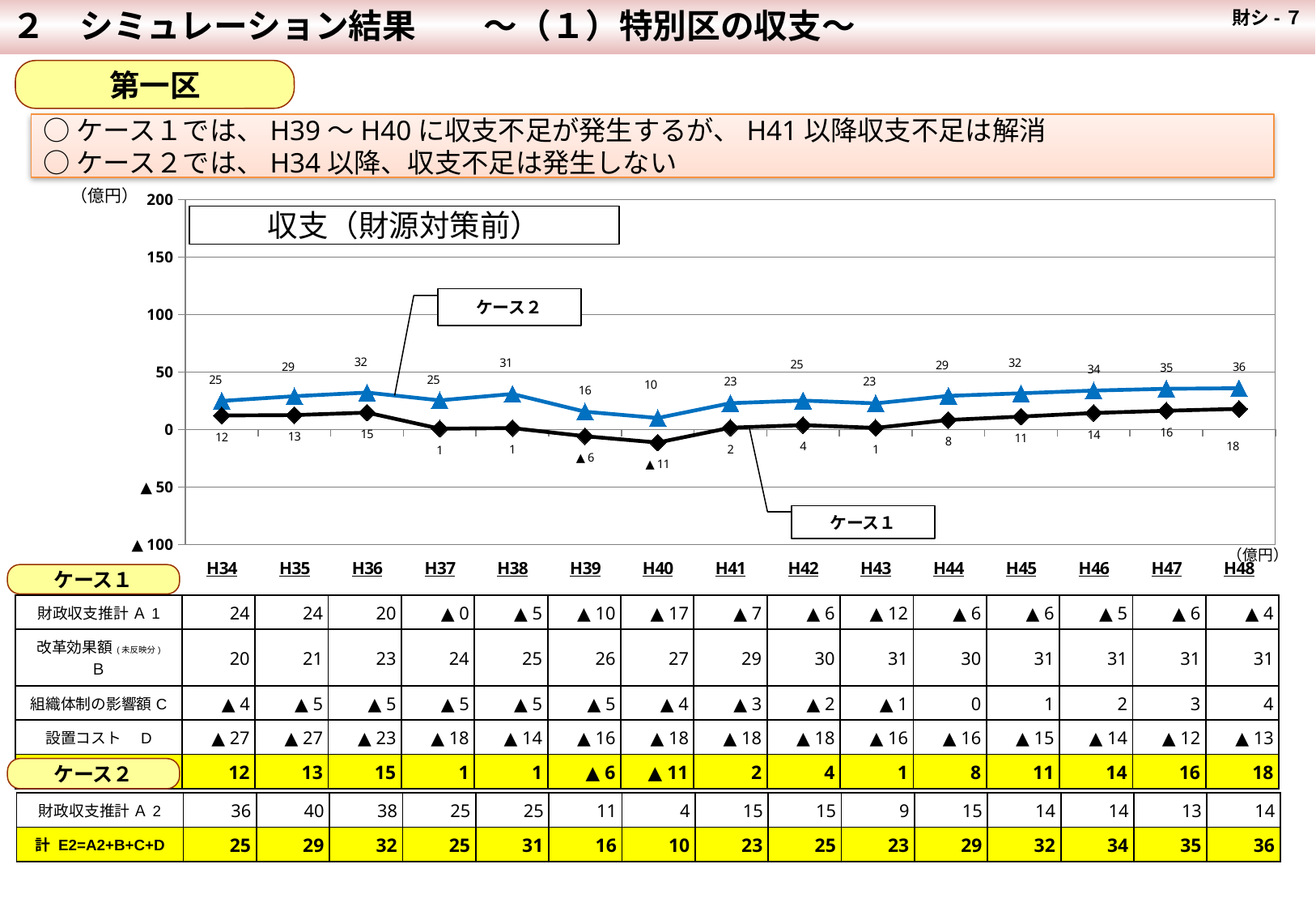
What is the value of ケース2 at H48? 36 What is the value of ケース2 at H40? 10 In which year does ケース2 reach its highest value? H48 Which series has the higher value at H38, ケース1 or ケース2? ケース2 What is the value of ケース1 at H39? ▲6 How many years (data points per series) are plotted along the x axis? 15 Do the values of ケース2 rise or fall from H41 to H48? rise How many series are plotted in the chart? 2 What type of chart is shown on the slide? line chart What is the difference between ケース2 and ケース1 at H36? 17 In which year does ケース1 reach its lowest value? H40 What is the title of the chart? 収支（財源対策前）